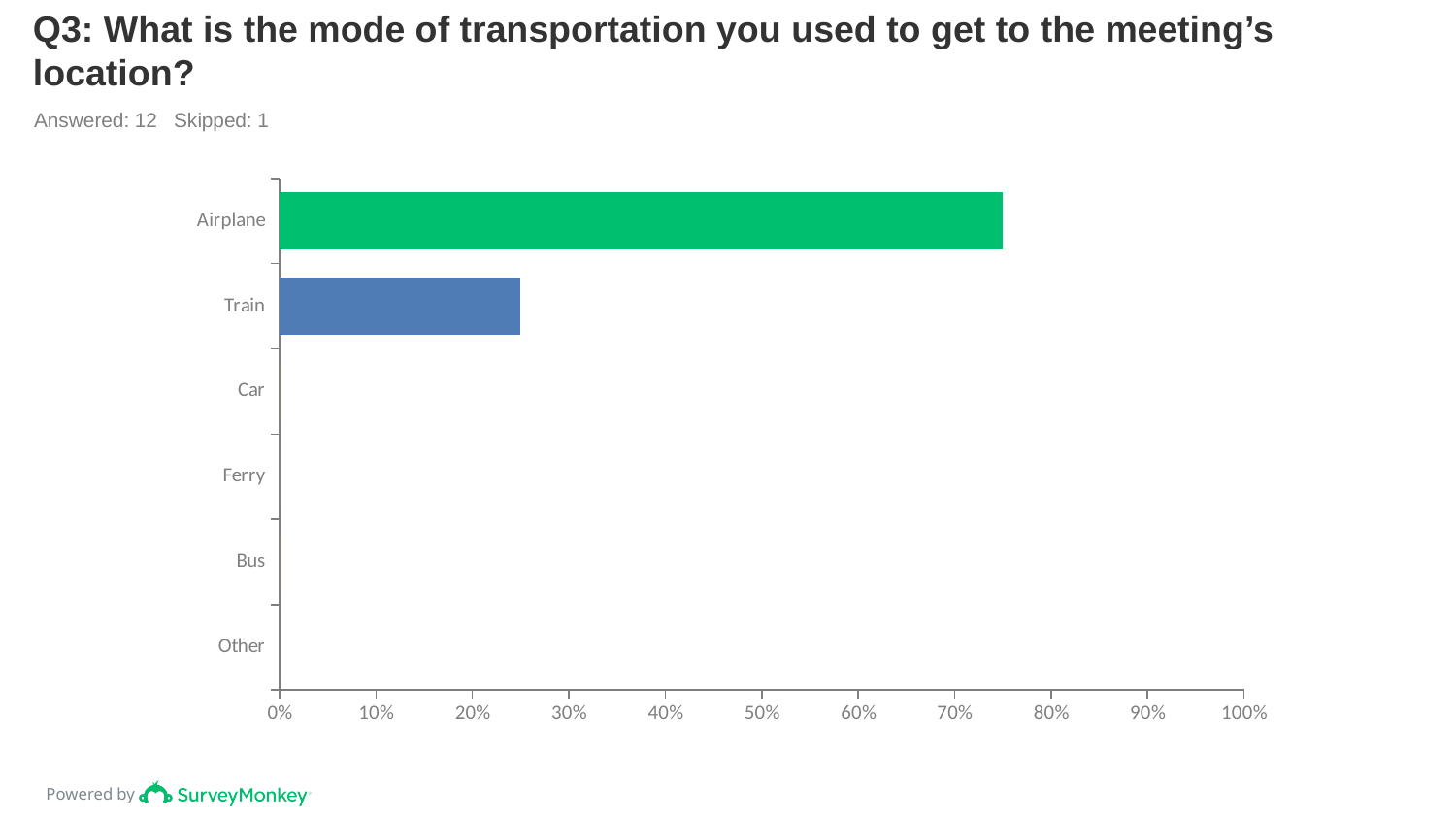
Is the value for Airplane greater or less than 70%? greater How many respondents answered this question according to the slide? 12 Is the value for Train greater or less than 20%? greater Is the value for Ferry greater or less than 10%? less What kind of chart is shown on the slide? bar chart Which is larger, the value for Airplane or the value for Train? Airplane Which mode of transportation has the highest percentage? Airplane What is the highest value shown on the horizontal axis? 100% How many transportation categories are listed on the chart? 6 What is the value shown for Car? 0%